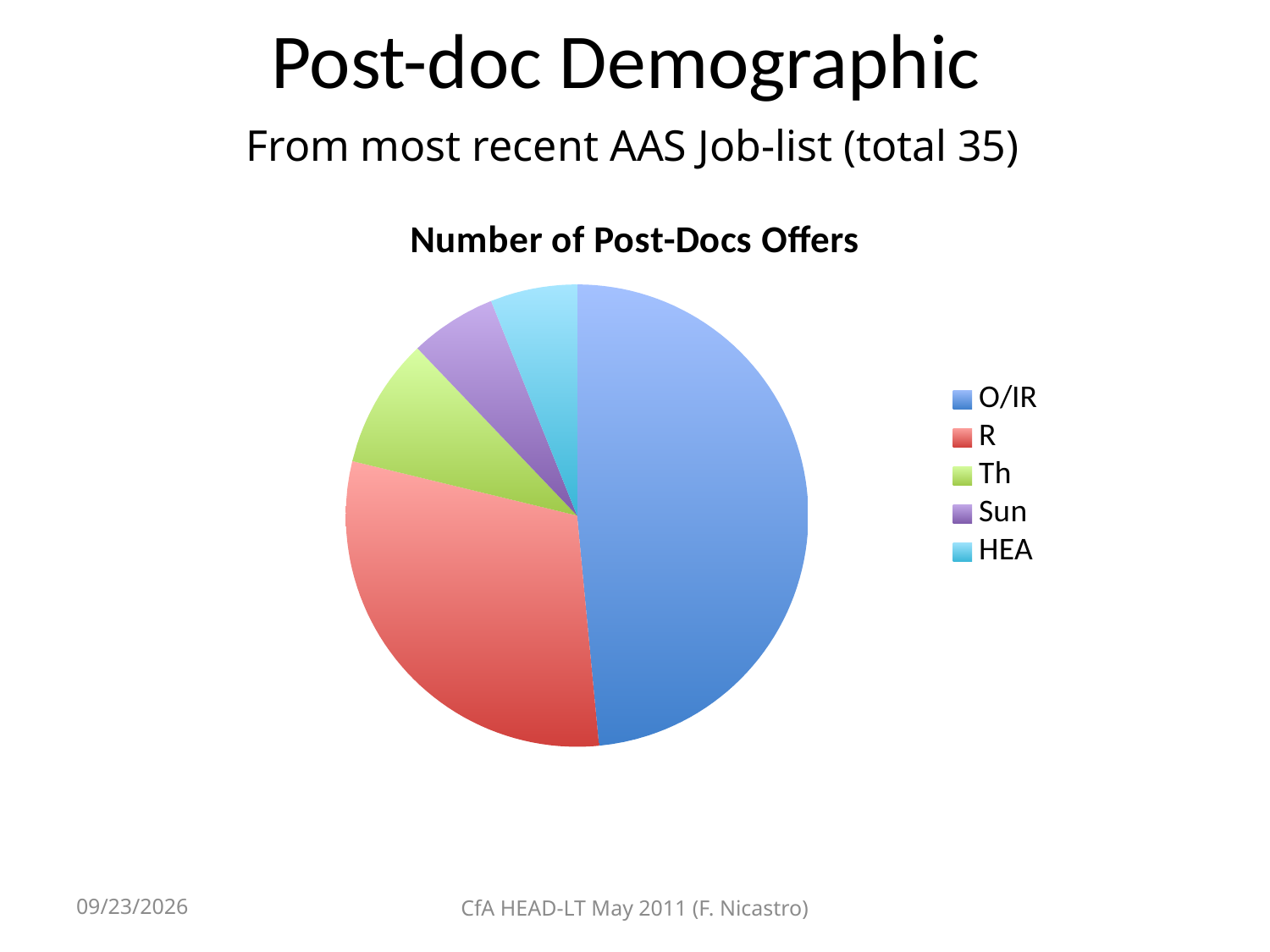
Which category is the second largest slice in the pie chart? R Which slice is larger, R or Th? R Which category has the largest slice in the pie chart? O/IR What kind of chart is shown on the slide? pie chart Which slice is larger, O/IR or R? O/IR How many categories does the legend of the pie chart list? 5 Which category is shown in red in the pie chart? R Which slice is larger, Th or HEA? Th What is the title of the pie chart? Number of Post-Docs Offers